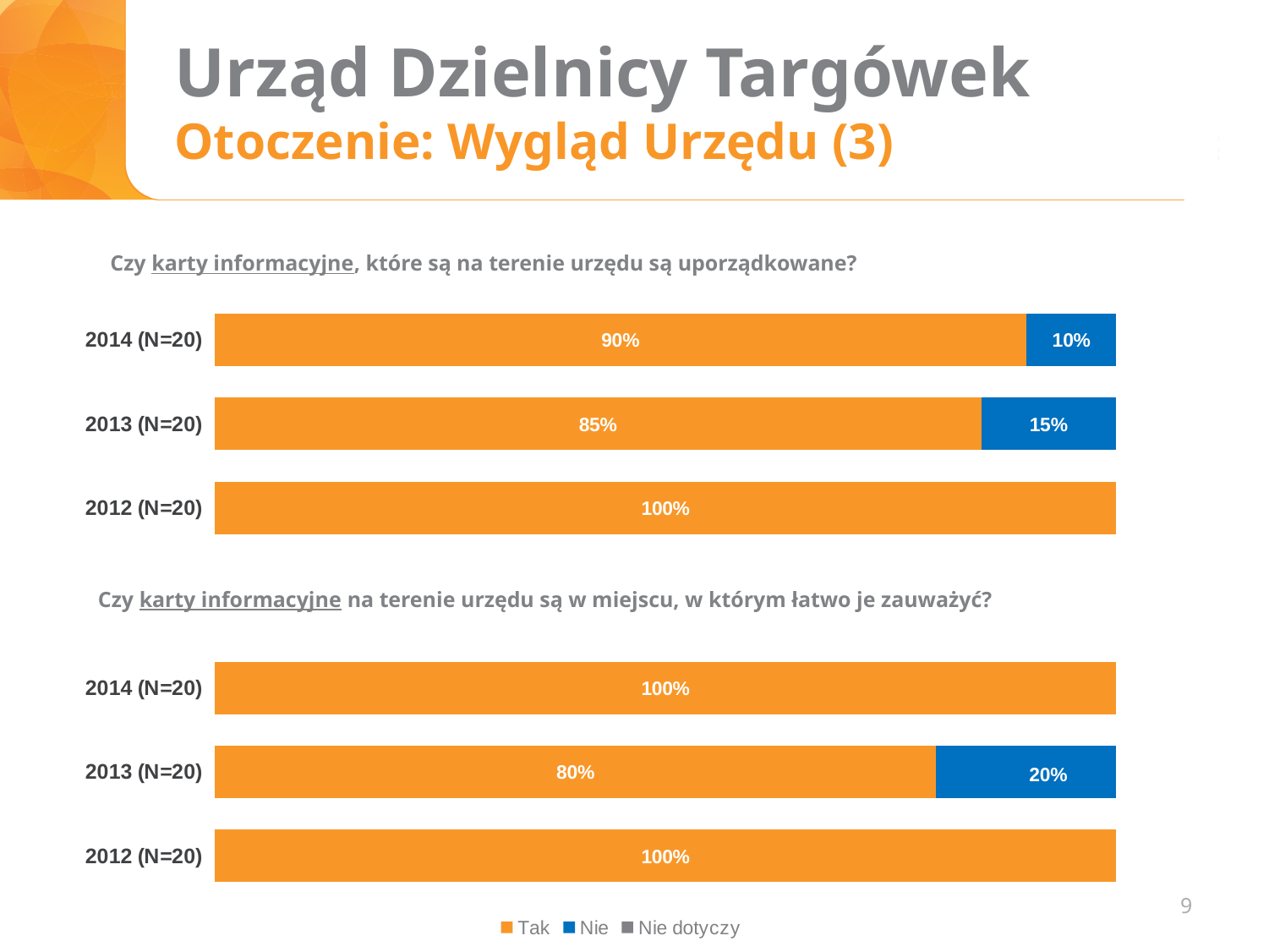
In the bottom chart ("Czy karty informacyjne na terenie urzędu są w miejscu, w którym łatwo je zauważyć?"), what is the "Tak" value for 2013 (N=20)? 80% In the bottom chart ("Czy karty informacyjne na terenie urzędu są w miejscu, w którym łatwo je zauważyć?"), which year has the lowest "Tak" value? 2013 (N=20) In the top chart ("Czy karty informacyjne, które są na terenie urzędu są uporządkowane?"), what is the "Nie" value for 2013 (N=20)? 15% How many year categories does the top chart show? 3 In the bottom chart ("Czy karty informacyjne na terenie urzędu są w miejscu, w którym łatwo je zauważyć?"), what is the total of the 2013 (N=20) bar? 100% What kind of chart is the bottom chart? Stacked bar chart In the bottom chart ("Czy karty informacyjne na terenie urzędu są w miejscu, w którym łatwo je zauważyć?"), what is the "Nie" value for 2013 (N=20)? 20% In the top chart ("Czy karty informacyjne, które są na terenie urzędu są uporządkowane?"), what is the "Tak" value for 2014 (N=20)? 90% In the top chart ("Czy karty informacyjne, które są na terenie urzędu są uporządkowane?"), which is larger: the "Nie" value for 2014 or for 2013? 2013 In the top chart ("Czy karty informacyjne, które są na terenie urzędu są uporządkowane?"), what is the difference between the "Tak" values for 2014 and 2013? 5% In the top chart ("Czy karty informacyjne, które są na terenie urzędu są uporządkowane?"), which year has the highest "Tak" value? 2012 (N=20) How many series does the legend at the bottom of the slide list? 3